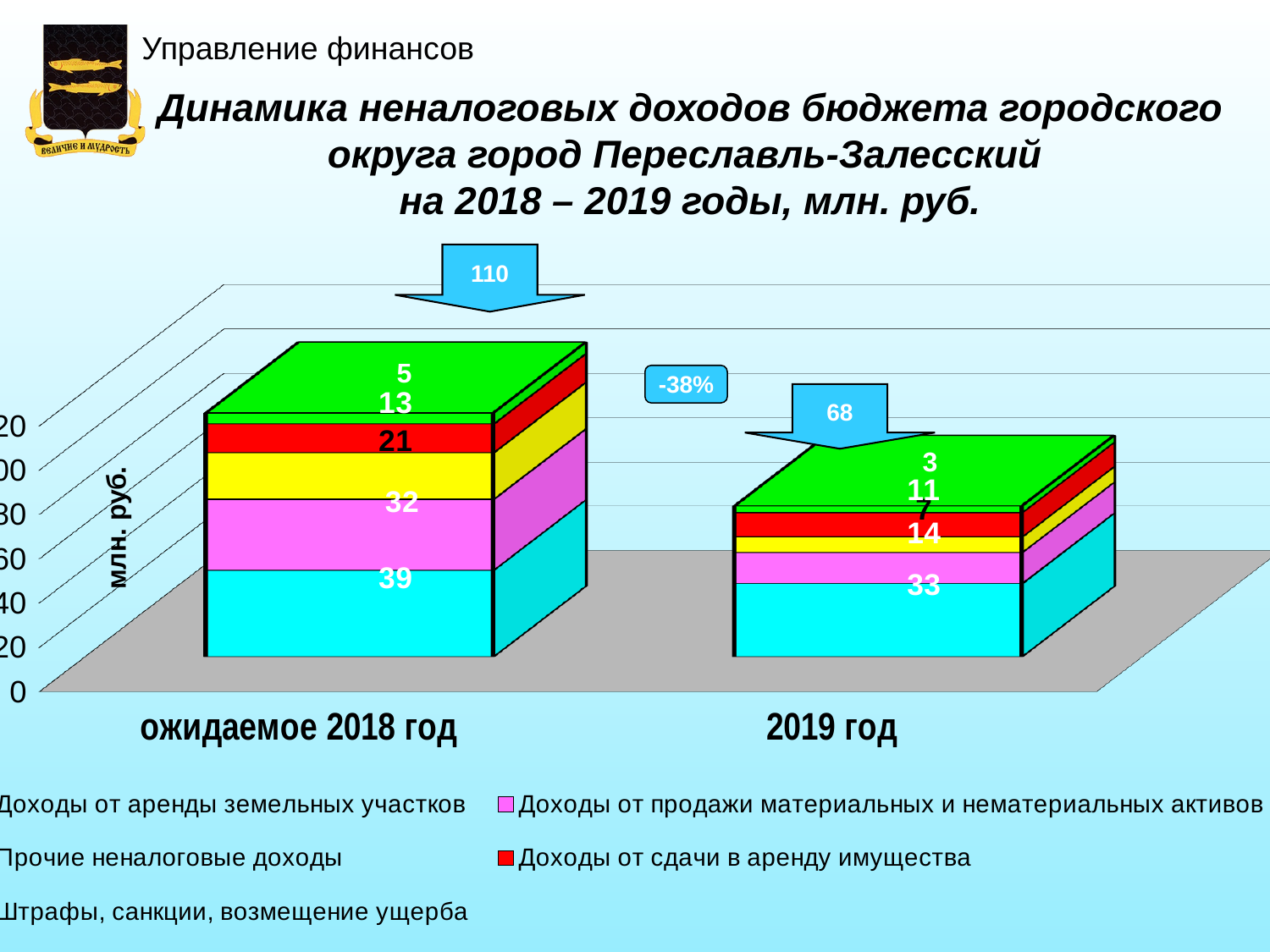
What is the difference between the 'Доходы от сдачи в аренду имущества' values for 'ожидаемое 2018 год' and '2019 год'? 2 What type of chart is shown on the slide? stacked bar chart What is the value of 'Доходы от продажи материальных и нематериальных активов' for '2019 год'? 14 What is the value of 'Штрафы, санкции, возмещение ущерба' for '2019 год'? 3 What percentage change between the two bars is shown on the chart? -38% How many categories (years) are shown on the x axis of the chart? 2 What is the value of 'Доходы от аренды земельных участков' for 'ожидаемое 2018 год'? 39 How many series does the legend list? 5 What is the value of 'Прочие неналоговые доходы' for 'ожидаемое 2018 год'? 21 What is the total of the stacked bar for '2019 год'? 68 Which year has the larger value for 'Доходы от продажи материальных и нематериальных активов'? ожидаемое 2018 год What is the total of the stacked bar for 'ожидаемое 2018 год'? 110